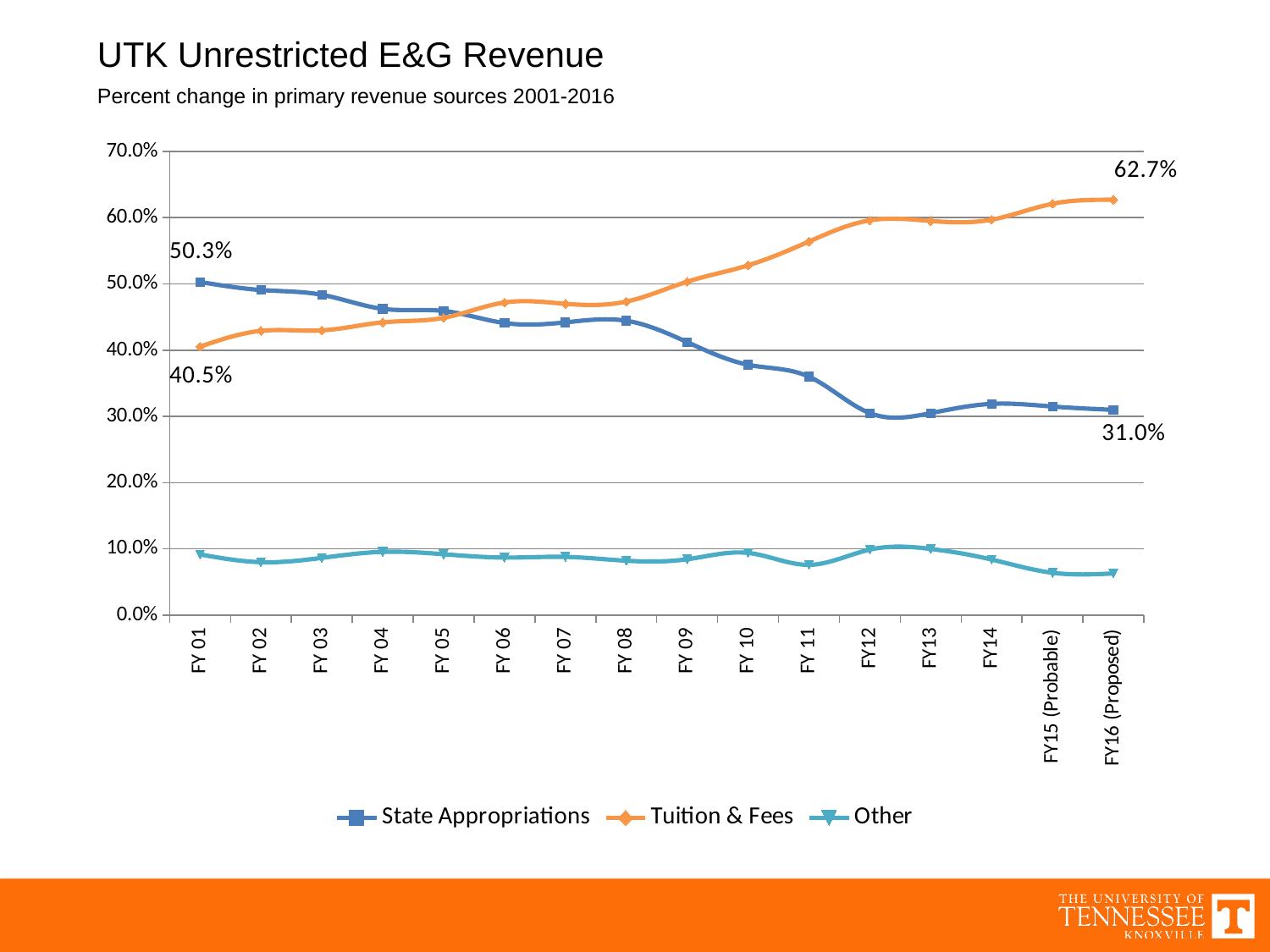
Is the value for Other in FY16 (Proposed) greater or less than 10.0%? less In FY 01, which is larger: State Appropriations or Tuition & Fees? State Appropriations What is the value for Tuition & Fees in FY 01? 40.5% How many series does the legend list? 3 Which series has the highest value in FY16 (Proposed)? Tuition & Fees What is the value for State Appropriations in FY16 (Proposed)? 31.0% What is the value for State Appropriations in FY 01? 50.3% In FY16 (Proposed), how many percentage points higher is Tuition & Fees than State Appropriations? 31.7 percentage points What kind of chart is shown on the slide? line chart What is the value for Tuition & Fees in FY16 (Proposed)? 62.7% By how many percentage points does State Appropriations fall from FY 01 to FY16 (Proposed)? 19.3 percentage points Does the Tuition & Fees line rise or fall from FY 01 to FY16 (Proposed)? rise